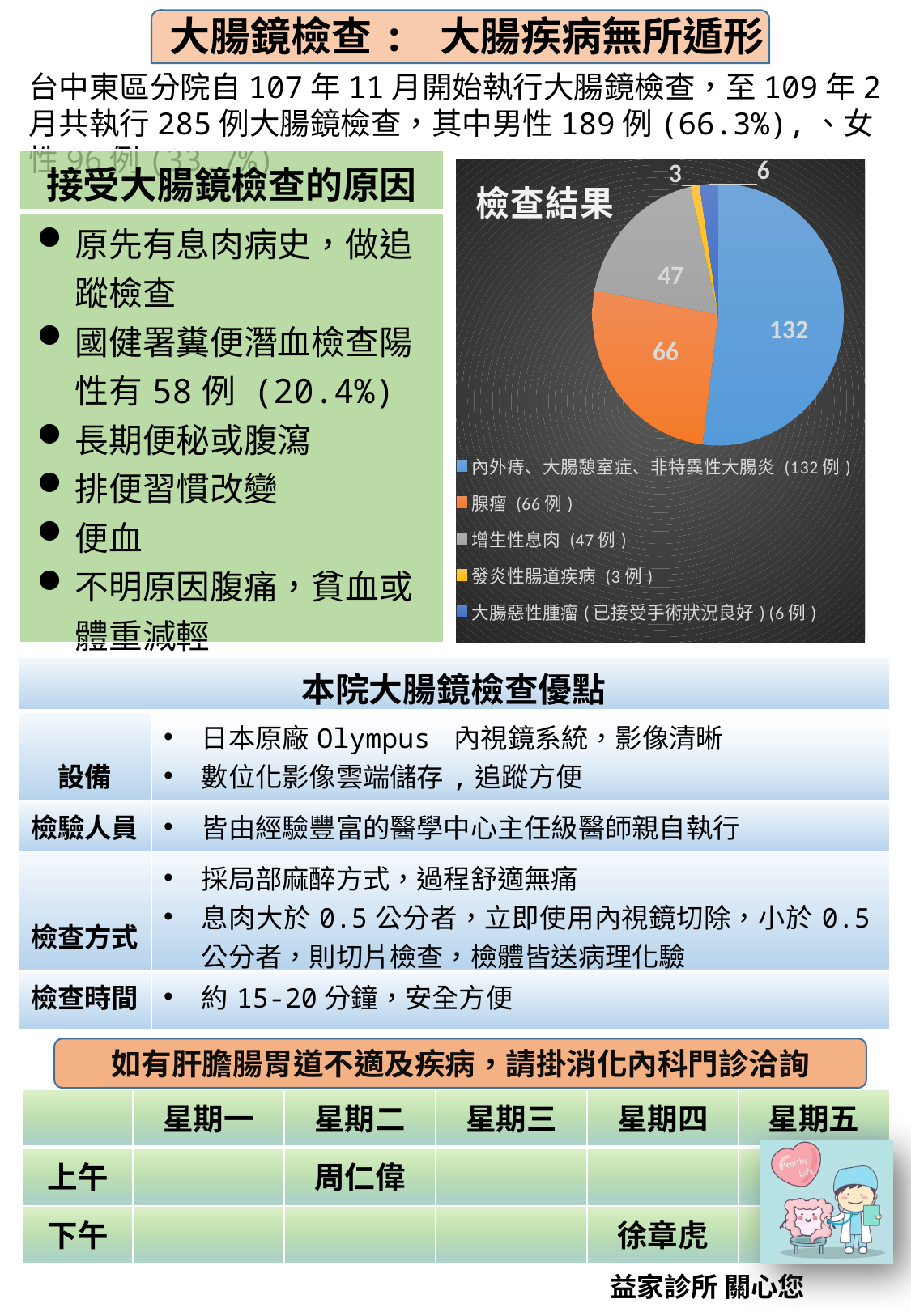
In the 檢查結果 pie chart, how many cases are labelled for 腺瘤? 66 How many categories does the 檢查結果 pie chart show? 5 In the 檢查結果 pie chart, what is the difference between the number of 腺瘤 cases and 增生性息肉 cases? 19 What type of chart is shown under the title 檢查結果? pie chart Which category has the smallest slice in the 檢查結果 pie chart? 發炎性腸道疾病 Which category has the largest slice in the 檢查結果 pie chart? 內外痔、大腸憩室症、非特異性大腸炎 In the 檢查結果 pie chart, which is larger: 大腸惡性腫瘤 or 發炎性腸道疾病? 大腸惡性腫瘤 What colour is the 腺瘤 slice in the 檢查結果 pie chart? orange In the 檢查結果 pie chart, how many cases are labelled for 大腸惡性腫瘤? 6 What is the total number of cases across all slices of the 檢查結果 pie chart? 254 In the 檢查結果 pie chart, how many cases are labelled for 增生性息肉? 47 In the 檢查結果 pie chart, how many cases are labelled for 發炎性腸道疾病? 3